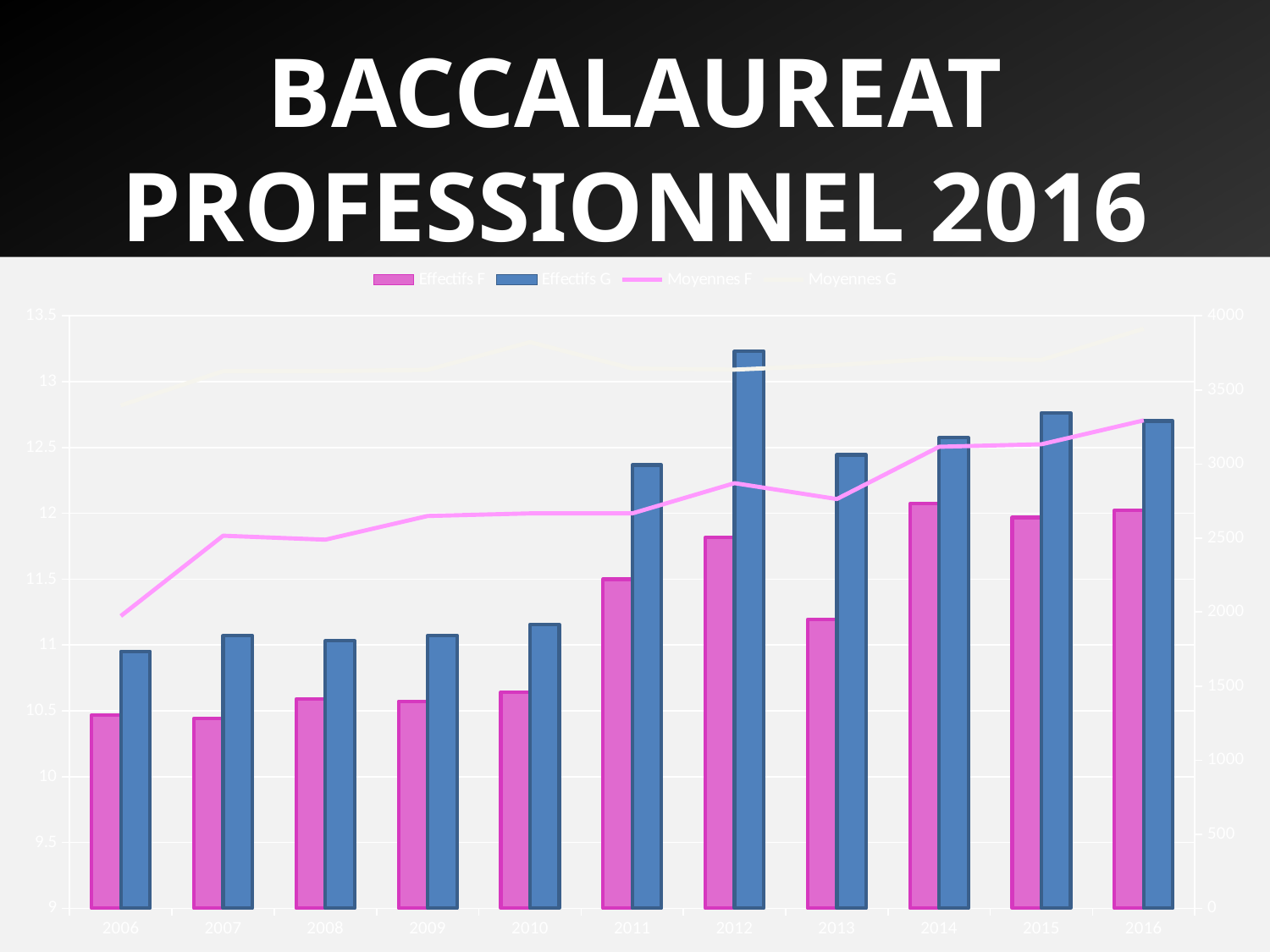
What are the four entries in the chart legend? Effectifs F, Effectifs G, Moyennes F, Moyennes G What kind of chart is shown on the slide? A combined bar and line chart Which is larger, the Effectifs G bar for 2012 or for 2011? 2012 How many years are shown on the x axis? 11 What colour are the Effectifs F bars? Pink How many series does the legend list? 4 Does the Moyennes F line generally rise or fall from 2006 to 2016? Rise Is the Moyennes F value for 2006 greater or less than 11.5 on the left axis? less Which is larger, the Effectifs F bar for 2011 or for 2010? 2011 Is the Moyennes F value for 2016 greater or less than 12.5 on the left axis? greater Which is larger in 2013, the Effectifs F bar or the Effectifs G bar? Effectifs G In which year is the Effectifs G bar the highest? 2012